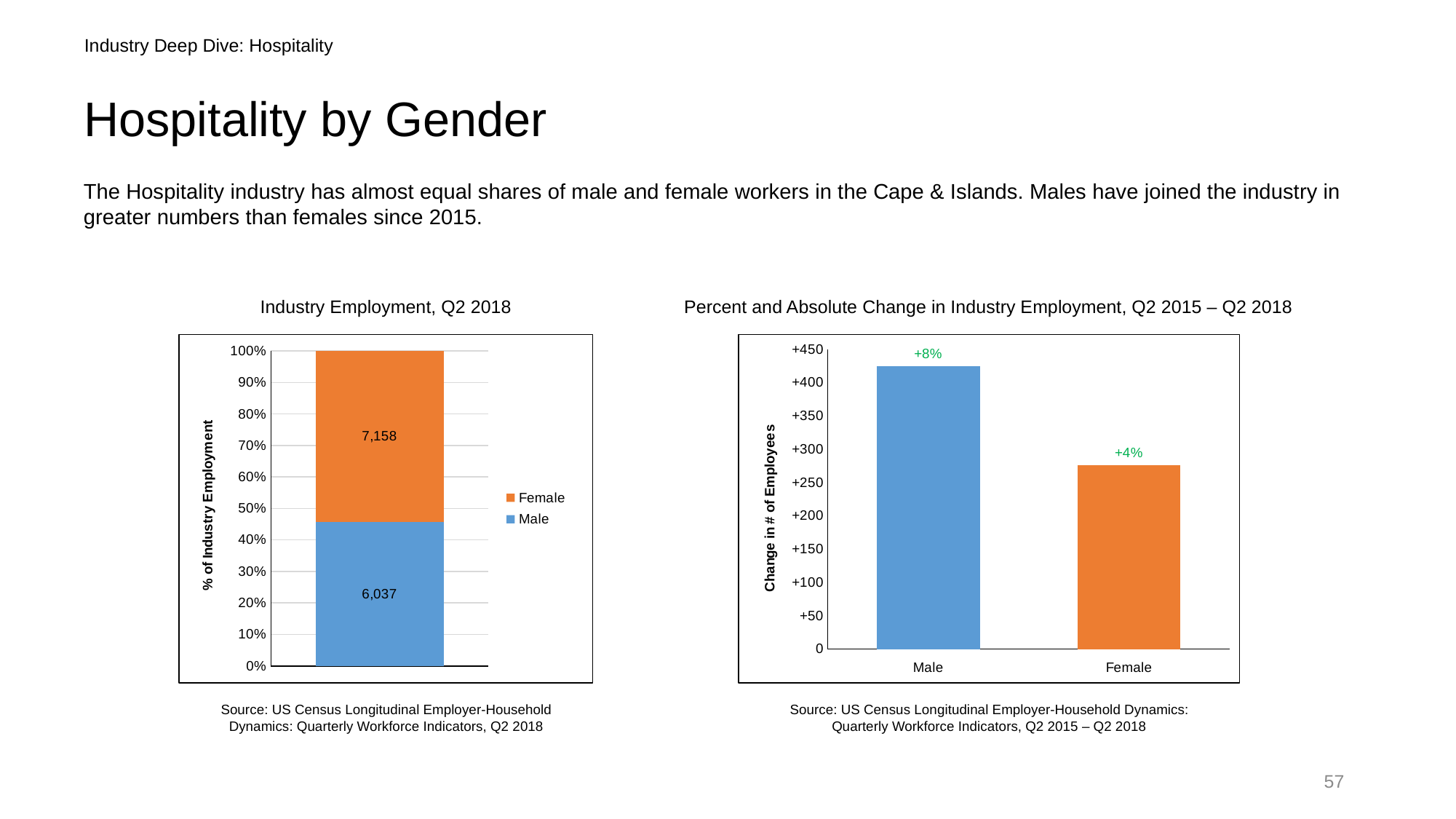
In the 'Industry Employment, Q2 2018' chart, what is the value shown for Male? 6,037 In the 'Percent and Absolute Change in Industry Employment, Q2 2015 – Q2 2018' chart, is the value for Male greater or less than +400? greater In the 'Industry Employment, Q2 2018' chart, which gender has the larger number of employees? Female In the 'Percent and Absolute Change in Industry Employment, Q2 2015 – Q2 2018' chart, what percent change is shown for Female? +4% In the 'Industry Employment, Q2 2018' chart, what is the difference between the Female and Male values? 1,121 In the 'Industry Employment, Q2 2018' chart, what is the value shown for Female? 7,158 In the 'Industry Employment, Q2 2018' chart, what is the total of the stacked bar (Female plus Male)? 13,195 How many series does the legend of the 'Industry Employment, Q2 2018' chart list? 2 In the 'Industry Employment, Q2 2018' chart, which colour represents Male? Blue In the 'Percent and Absolute Change in Industry Employment, Q2 2015 – Q2 2018' chart, is the value for Female greater or less than +300? less In the 'Percent and Absolute Change in Industry Employment, Q2 2015 – Q2 2018' chart, which category has the highest change in number of employees? Male In the 'Percent and Absolute Change in Industry Employment, Q2 2015 – Q2 2018' chart, what percent change is shown for Male? +8%